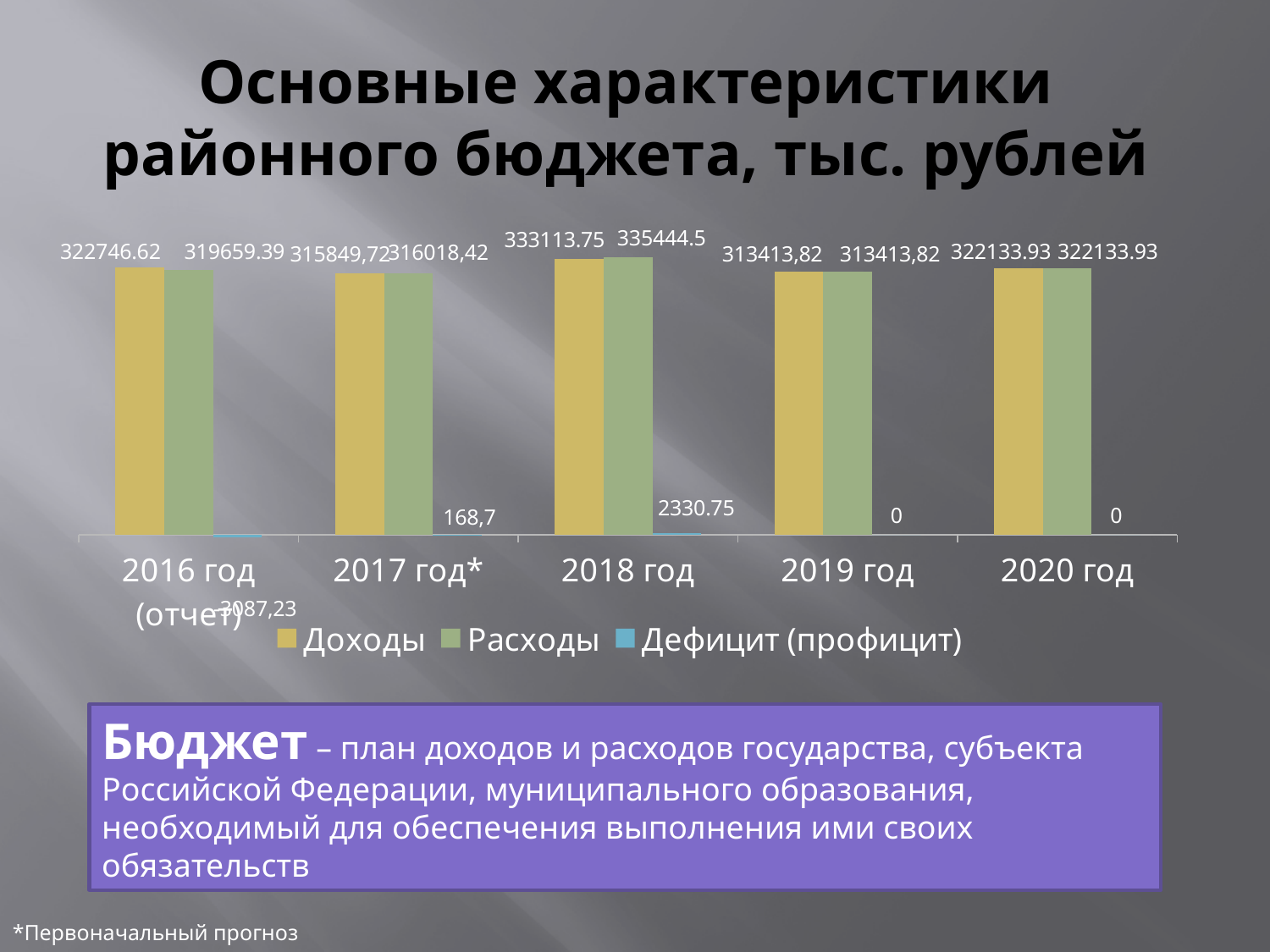
What is the value of Дефицит (профицит) for 2019 год? 0 What is the value of Расходы for 2018 год? 335444.5 What is the value of Дефицит (профицит) for 2017 год*? 168,7 How many years (categories) are shown on the x axis? 5 What is the value of Доходы for 2016 год (отчет)? 322746.62 What is the value of Расходы for 2020 год? 322133.93 For 2018 год, which is larger: Доходы or Расходы? Расходы What is the title of the slide? Основные характеристики районного бюджета, тыс. рублей In which year is Расходы the highest? 2018 год What is the difference between Доходы and Расходы for 2016 год (отчет)? 3087.23 What kind of chart is shown on the slide? Bar chart How many series does the legend list? 3